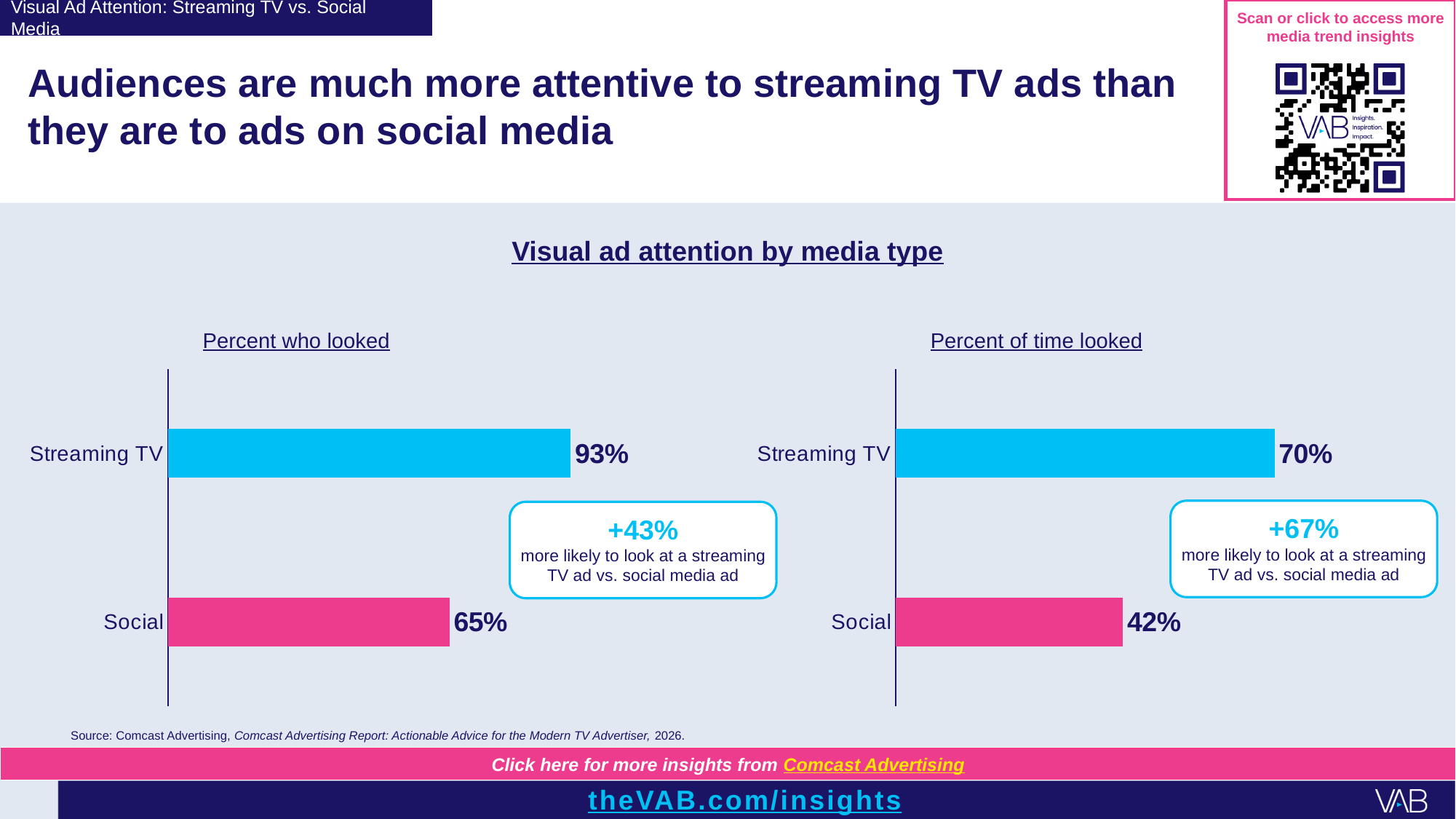
In the 'Percent of time looked' chart, which is larger: Streaming TV or Social? Streaming TV In the 'Percent who looked' chart, what is the value for Social? 65% What type of chart is the 'Percent of time looked' chart? Bar chart In the 'Percent of time looked' chart, what is the value for Social? 42% What is the overall title above the two charts? Visual ad attention by media type How many categories are shown in the 'Percent who looked' chart? 2 In the 'Percent who looked' chart, what is the value for Streaming TV? 93% In the 'Percent of time looked' chart, what is the value for Streaming TV? 70% In the 'Percent who looked' chart, which category has the highest value? Streaming TV In the 'Percent of time looked' chart, what is the difference between the Streaming TV and Social values? 28% In the 'Percent who looked' chart, what is the difference between the Streaming TV and Social values? 28% In the 'Percent of time looked' chart, which category has the lowest value? Social